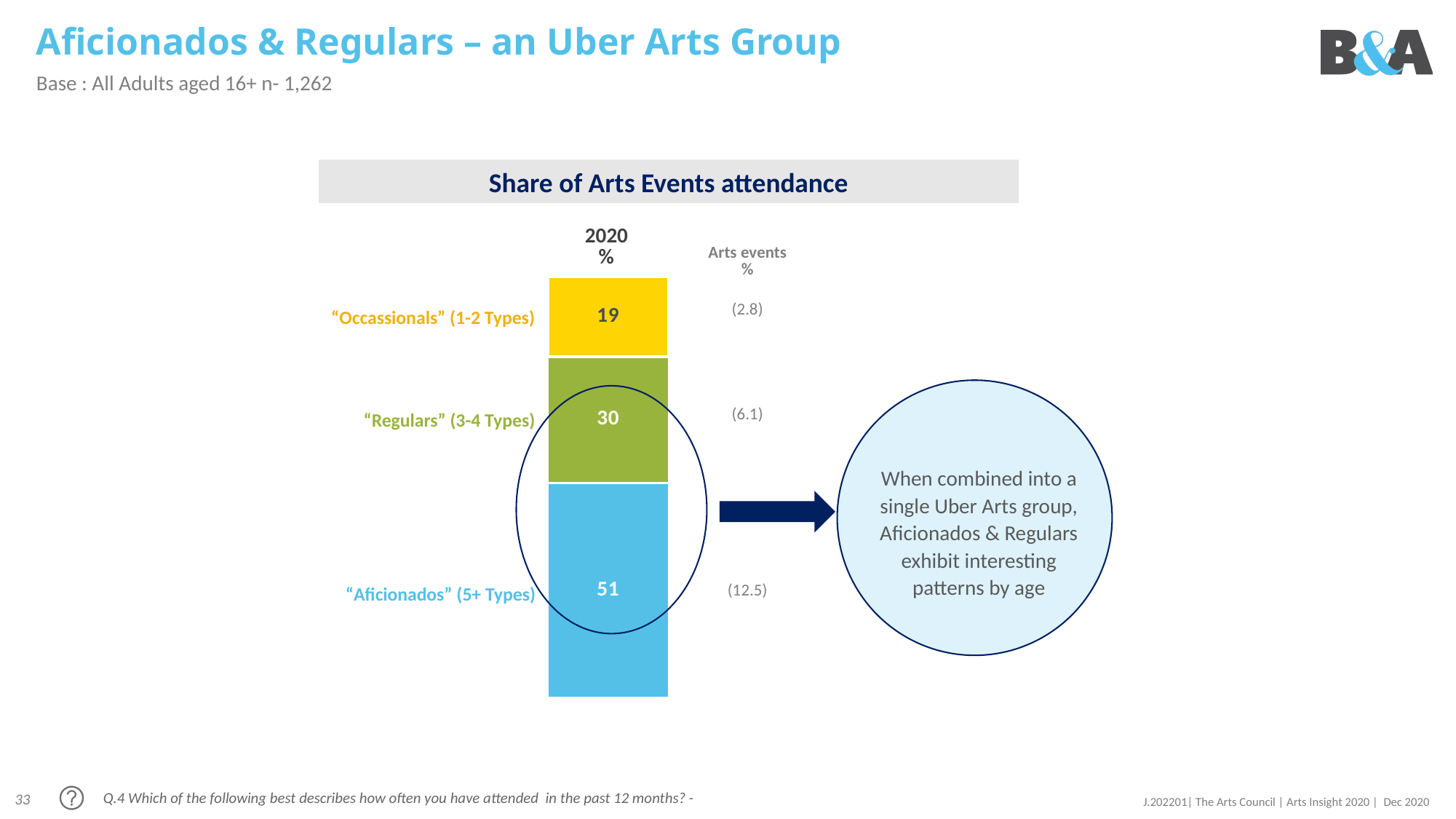
What kind of chart is shown on the slide? Stacked bar chart What is the 2020 % value for "Regulars" (3-4 Types)? 30 What is the difference between the 2020 % values for "Aficionados" and "Regulars"? 21 Which segment has the smallest share in the stacked bar? "Occassionals" (1-2 Types) What is the Arts events % figure shown next to "Aficionados" (5+ Types)? (12.5) What is the 2020 % value for "Aficionados" (5+ Types) in the Share of Arts Events attendance chart? 51 What is the 2020 % value for "Occassionals" (1-2 Types)? 19 How many segments make up the stacked bar? 3 Which is larger, the 2020 % value for "Regulars" or for "Occassionals"? "Regulars" (3-4 Types) Which segment has the largest share in the stacked bar? "Aficionados" (5+ Types) What is the total of the three segments in the stacked bar? 100 What is the title of the chart? Share of Arts Events attendance